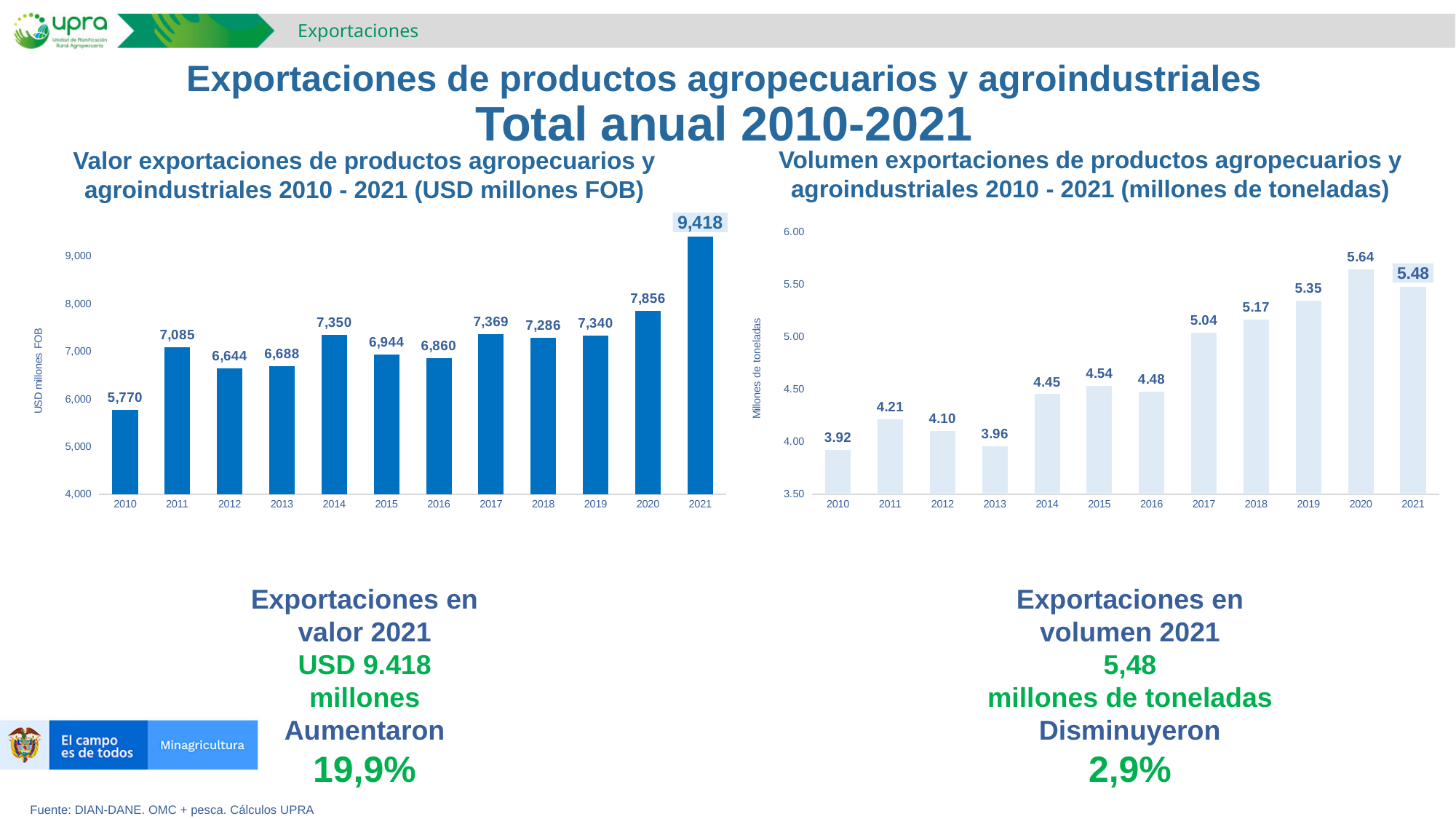
In the right chart (Volumen exportaciones), which year has the lowest value? 2010 In the right chart (Volumen exportaciones), which is larger, the value for 2015 or the value for 2016? 2015 In the right chart (Volumen exportaciones), what is the value for 2017? 5.04 In the right chart (Volumen exportaciones), what is the difference between the 2020 value and the 2021 value? 0.16 What is the y-axis label of the right chart (Volumen exportaciones)? Millones de toneladas In the left chart (Valor exportaciones), which year has the highest value? 2021 In the left chart (Valor exportaciones), which year has the lowest value? 2010 In the right chart (Volumen exportaciones), which year has the highest value? 2020 In the left chart (Valor exportaciones), what is the difference between the 2021 value and the 2020 value? 1,562 In the left chart (Valor exportaciones), what is the value for 2010? 5,770 In the left chart (Valor exportaciones), how many years are plotted? 12 What kind of chart is the left chart (Valor exportaciones)? Bar chart